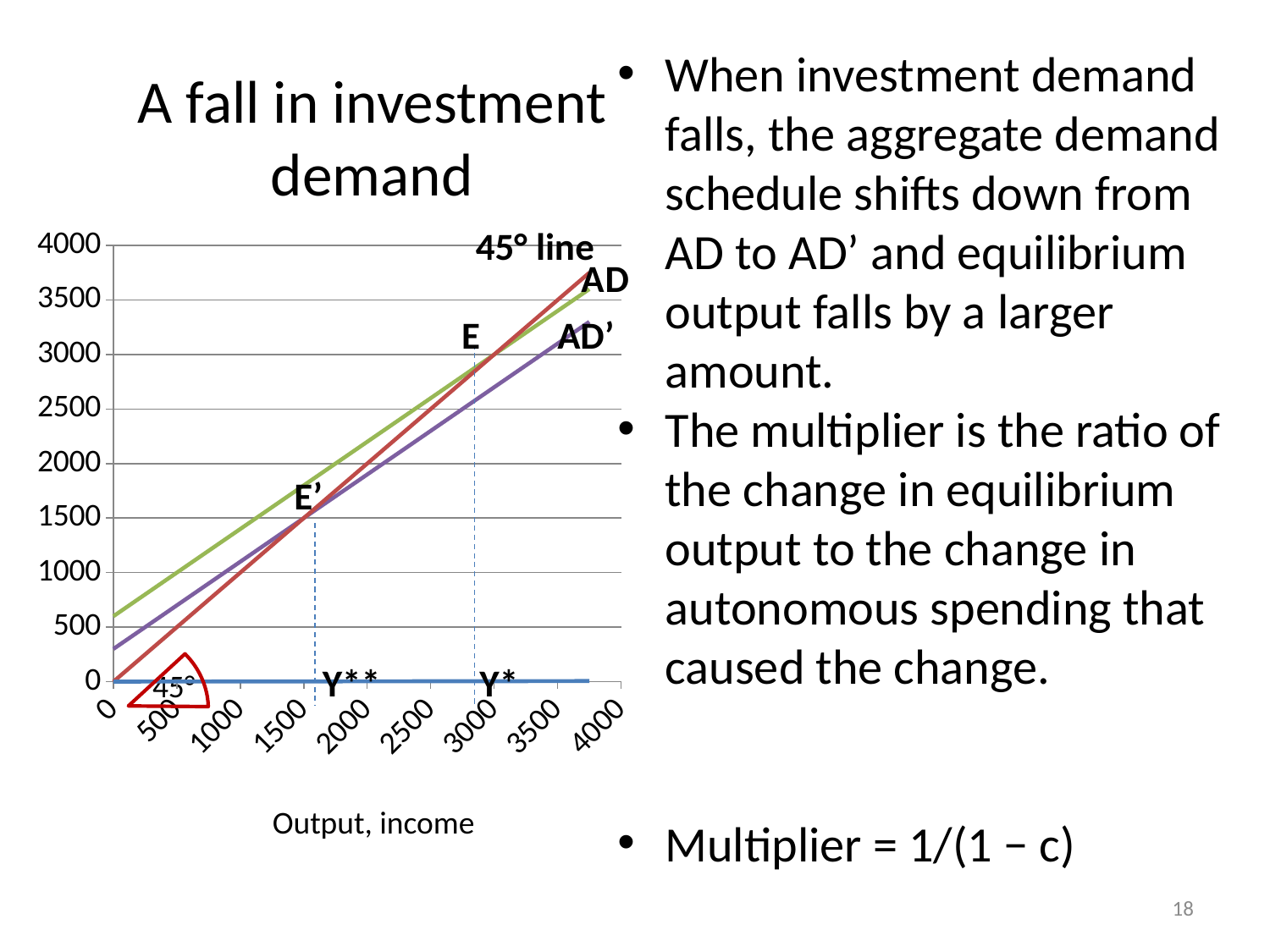
How many tick labels are shown on the horizontal axis? 9 Is the output level at equilibrium point E greater or less than 2500? greater What is the title of the chart's horizontal axis? Output, income What is the highest value shown on the vertical axis? 4000 At output 0, which line is higher, AD or AD'? AD Is the value of the AD' line at output 0 greater or less than 500? less Is the output level at equilibrium point E' greater or less than 2000? less What kind of chart is shown on the slide? line chart Which equilibrium point, E or E', lies at a higher output level? E Which of the labelled lines has the highest value at output 0? AD Do the AD and AD' lines rise or fall as output increases? rise